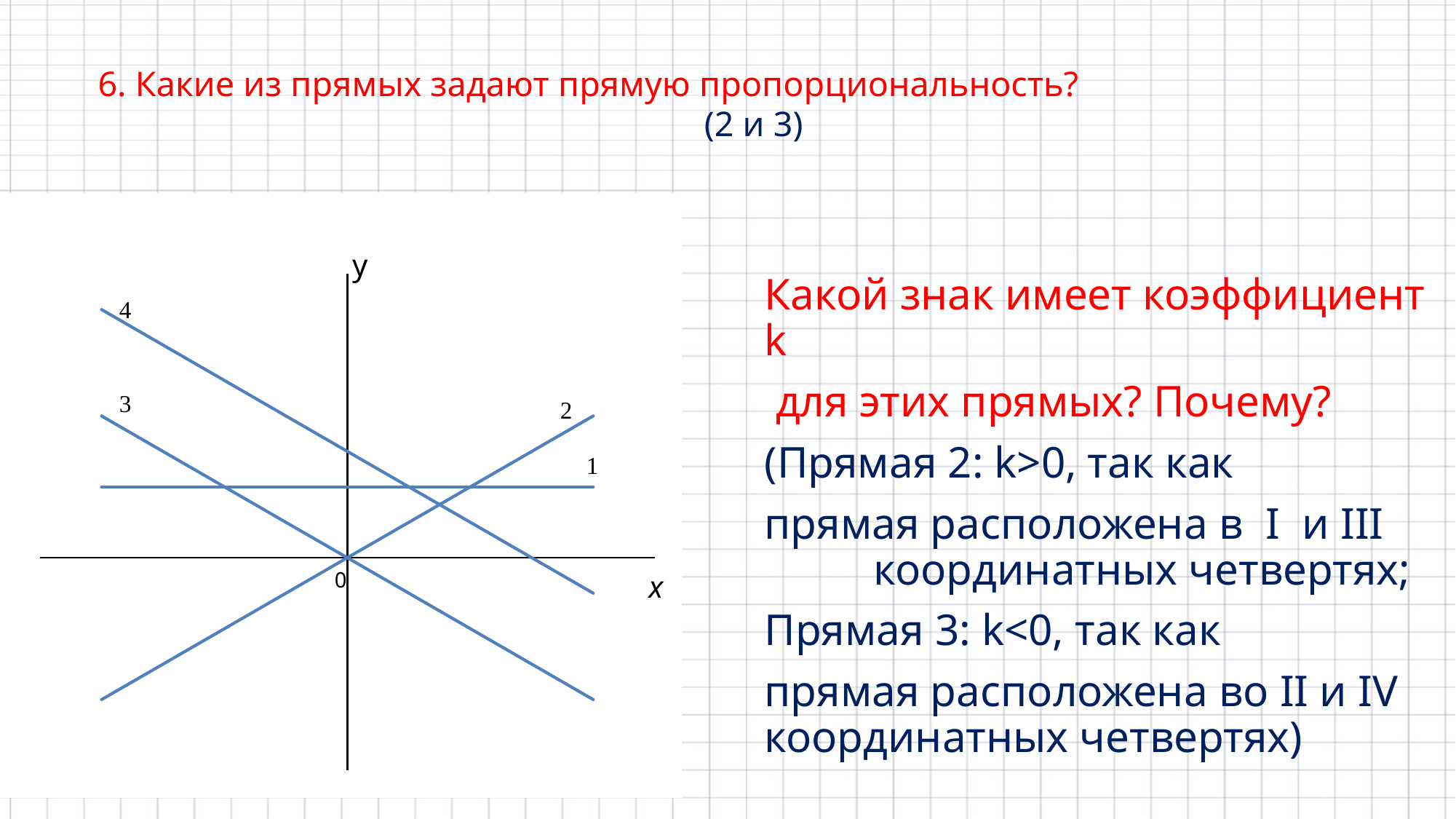
What kind of chart is shown on the slide? line chart Which numbered lines pass through the origin 0? 2 and 3 Which line has the highest label number? 4 Does line 2 rise or fall as x increases? rises Which line is horizontal? 1 What labels are given to the horizontal and vertical axes? x and y Does line 1 rise, fall, or stay flat as x increases? stays flat Does line 4 rise or fall as x increases? falls How many numbered lines are drawn on the coordinate plane? 4